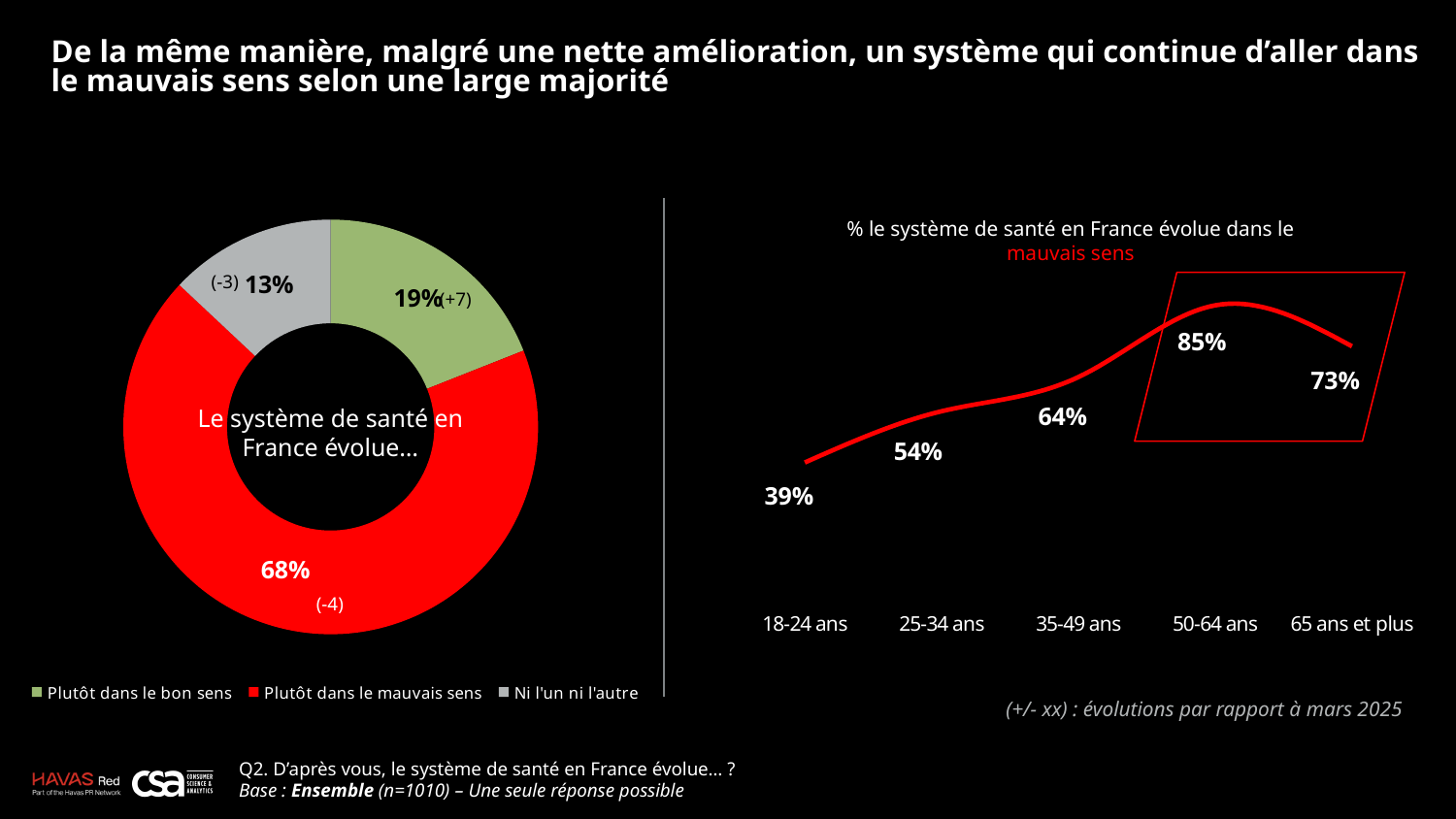
In the donut chart on the left, what is the change shown for 'Plutôt dans le bon sens' compared with March 2025? +7 In the donut chart on the left, what share of respondents answered 'Plutôt dans le bon sens'? 19% In the donut chart on the left, what share of respondents say the health system is evolving 'Plutôt dans le mauvais sens'? 68% In the donut chart on the left, how many entries does the legend list? 3 In the line chart on the right, which age group has the highest value? 50-64 ans In the line chart on the right, what percentage of 18-24 ans say the health system is evolving in the wrong direction? 39% In the donut chart on the left, which response has the smallest share? Ni l'un ni l'autre In the donut chart on the left, what share of respondents answered 'Ni l'un ni l'autre'? 13% In the line chart on the right, how many age groups are plotted? 5 In the line chart on the right, what is the difference between the values for 50-64 ans and 65 ans et plus? 12 points In the donut chart on the left, which response has the largest share? Plutôt dans le mauvais sens In the line chart on the right, what is the value for 50-64 ans? 85%